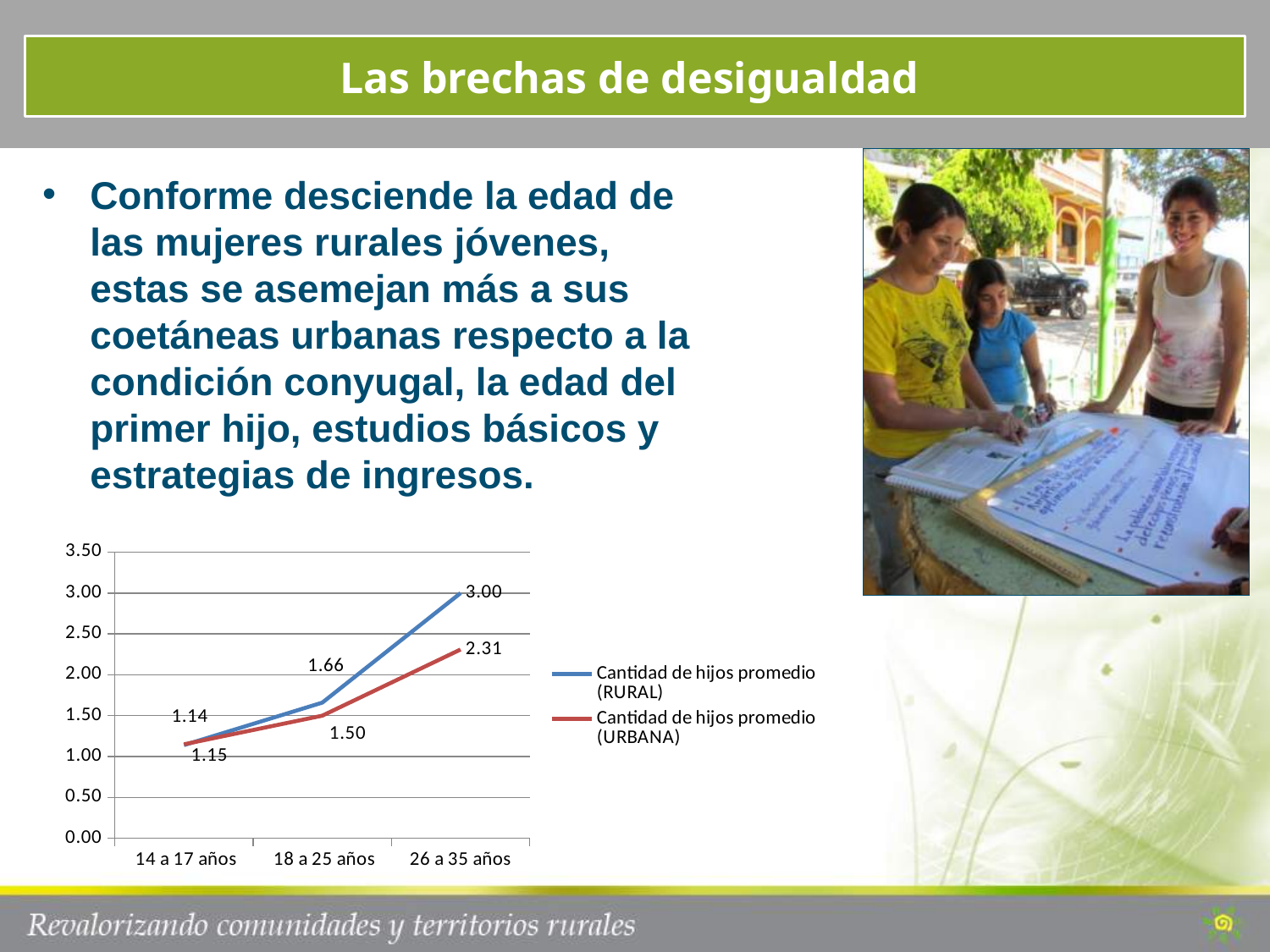
What is the difference between the RURAL and URBANA values for 18 a 25 años? 0.16 What is the value of Cantidad de hijos promedio (RURAL) for 18 a 25 años? 1.66 Do the values of Cantidad de hijos promedio (URBANA) rise or fall as age increases along the x axis? Rise For 26 a 35 años, which series has the larger value, RURAL or URBANA? RURAL What is the value of Cantidad de hijos promedio (URBANA) for 26 a 35 años? 2.31 What is the difference between the RURAL and URBANA values for 26 a 35 años? 0.69 For which age group is Cantidad de hijos promedio (RURAL) highest? 26 a 35 años How many series does the chart's legend list? 2 What is the value of Cantidad de hijos promedio (RURAL) for 26 a 35 años? 3.00 What is the value of Cantidad de hijos promedio (URBANA) for 18 a 25 años? 1.50 How many age categories are shown on the x axis of the chart? 3 What kind of chart is shown on the slide? Line chart